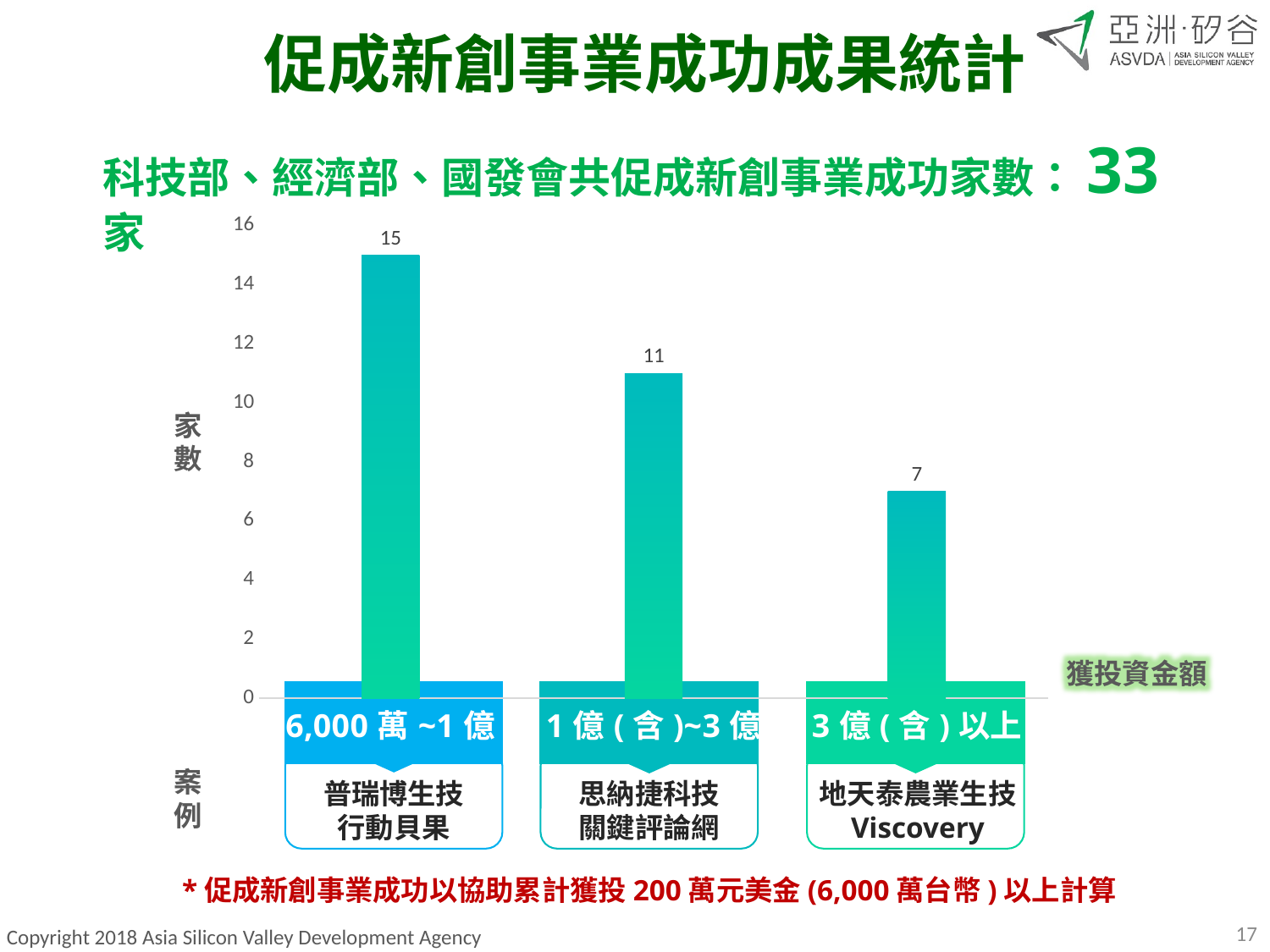
Which category has the highest value? 6,000萬~1億 What is the difference between the values for 1億(含)~3億 and 3億(含)以上? 4 Do the values rise or fall from left to right across the categories? fall Which category has the lowest value? 3億(含)以上 What is the value for the 1億(含)~3億 category? 11 How many categories are shown in the chart? 3 What is the value for the 3億(含)以上 category? 7 Is the value for 1億(含)~3億 greater or less than 10? greater Which is larger, the value for 6,000萬~1億 or the value for 1億(含)~3億? 6,000萬~1億 What kind of chart is shown on the slide? bar chart What is the difference between the values for 6,000萬~1億 and 3億(含)以上? 8 What is the value for the 6,000萬~1億 category? 15